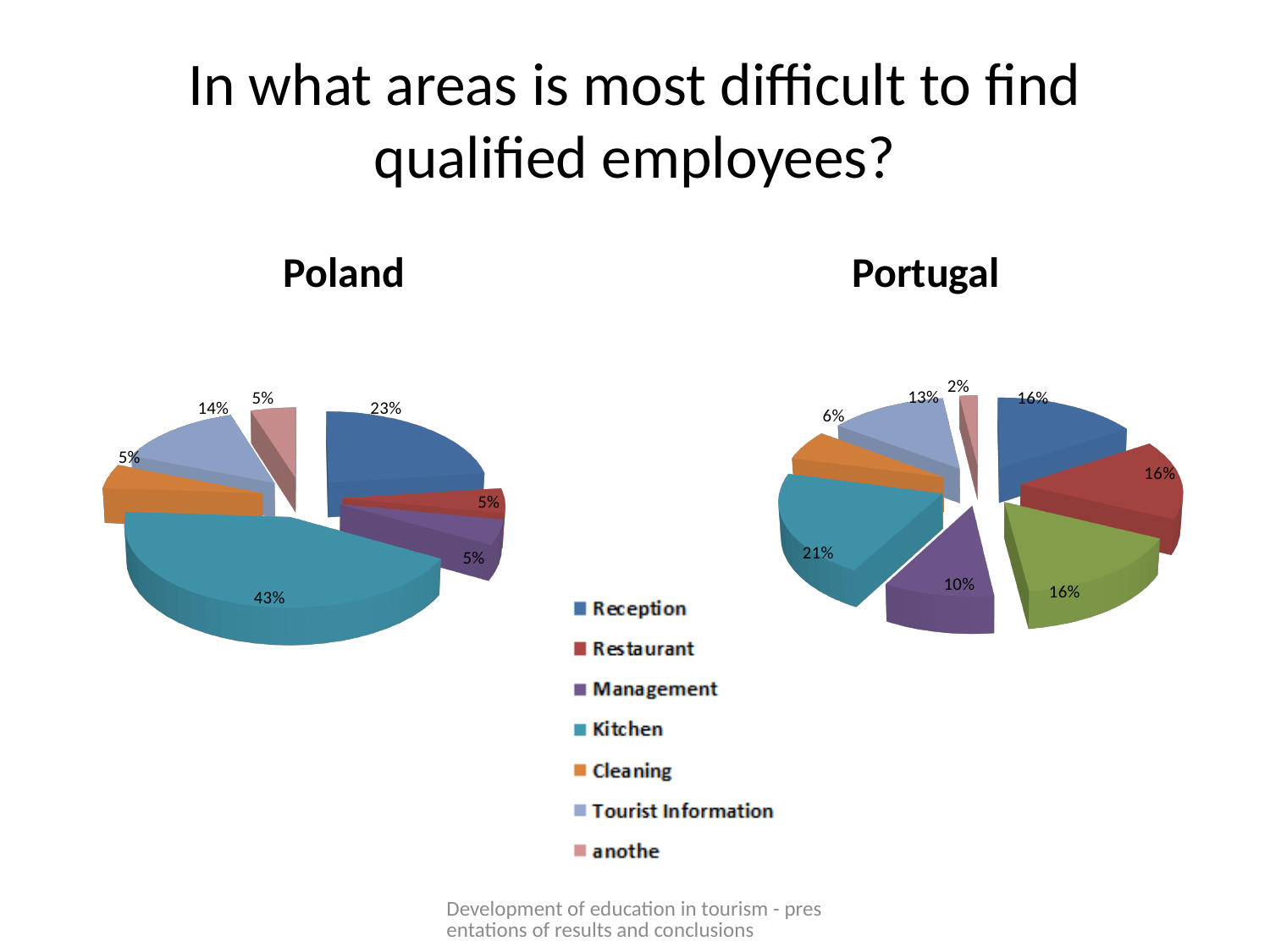
In the Poland pie chart, what share is shown for Kitchen? 43% How many entries does the legend list? 7 What kind of charts are shown on the slide? Pie charts In the Poland pie chart, what share is shown for Tourist Information? 14% In the Portugal pie chart, which area has the smallest slice? anothe In the Poland pie chart, how many percentage points larger is the Kitchen slice than the Reception slice? 20 percentage points In the Portugal pie chart, which area has the largest slice? Kitchen In the Poland pie chart, what share is shown for Reception? 23% In the Poland pie chart, which area has the largest slice? Kitchen In the Portugal pie chart, what share is shown for Cleaning? 6% Which chart shows a larger share for Kitchen, Poland or Portugal? Poland In the Portugal pie chart, what share is shown for Kitchen? 21%